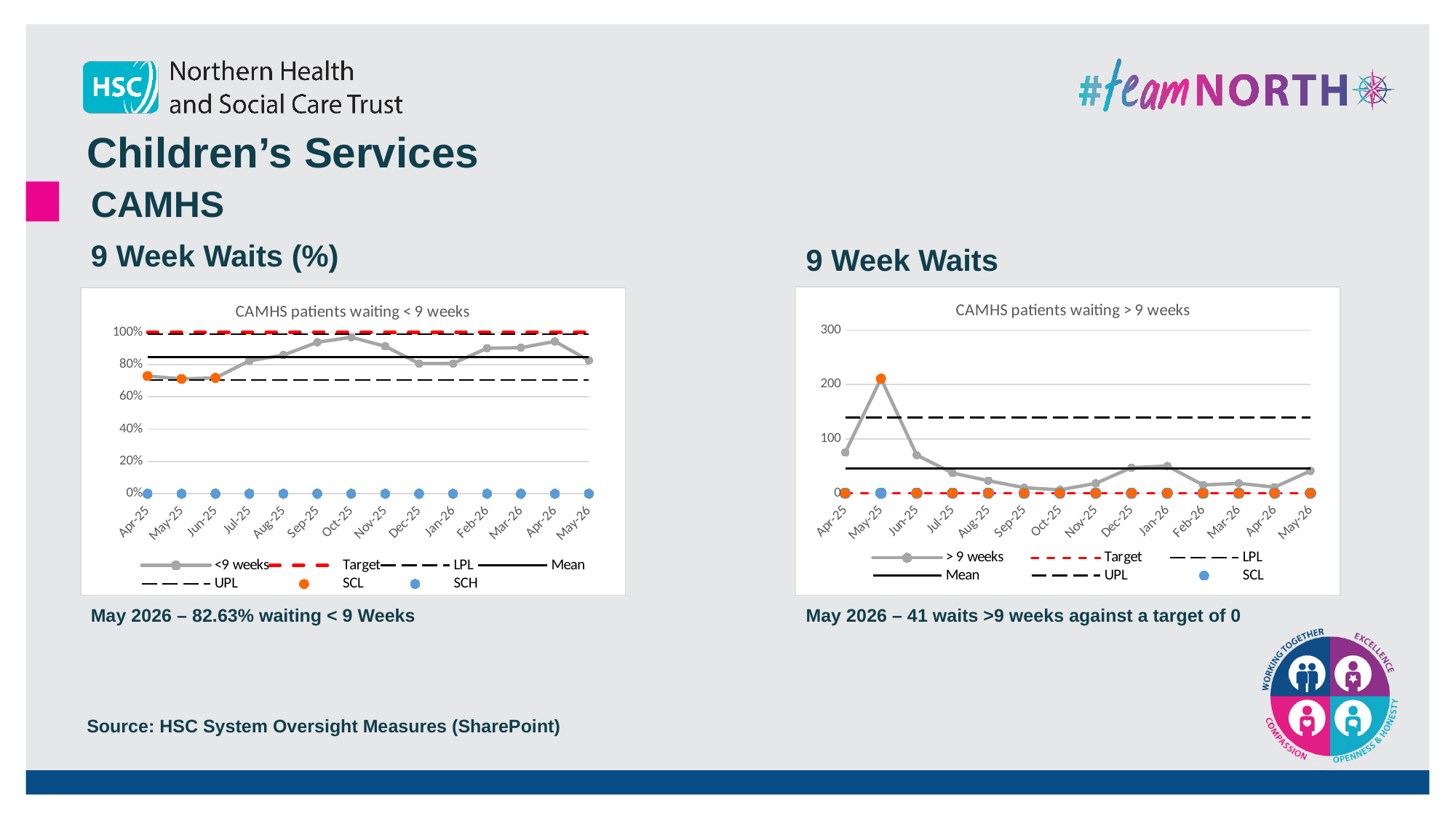
On the left chart (CAMHS patients waiting < 9 weeks), which is larger, the value for Oct-25 or the value for Dec-25? Oct-25 How many entries does the legend of the left chart (CAMHS patients waiting < 9 weeks) list? 7 On the left chart (CAMHS patients waiting < 9 weeks), what percentage was waiting < 9 weeks in May 2026? 82.63% On the left chart (CAMHS patients waiting < 9 weeks), is the value for Oct-25 greater or less than 80%? greater On the right chart (CAMHS patients waiting > 9 weeks), which month has the highest number of patients waiting > 9 weeks? May-25 On the right chart (CAMHS patients waiting > 9 weeks), is the value for Apr-25 greater or less than 100? less On the right chart (CAMHS patients waiting > 9 weeks), what is the target value? 0 On the left chart (CAMHS patients waiting < 9 weeks), is the value for Apr-25 greater or less than 80%? less How many months are plotted on the x axis of the right chart (CAMHS patients waiting > 9 weeks)? 14 What kind of chart is the right chart (CAMHS patients waiting > 9 weeks)? Line chart On the right chart (CAMHS patients waiting > 9 weeks), how many waits > 9 weeks were there in May 2026? 41